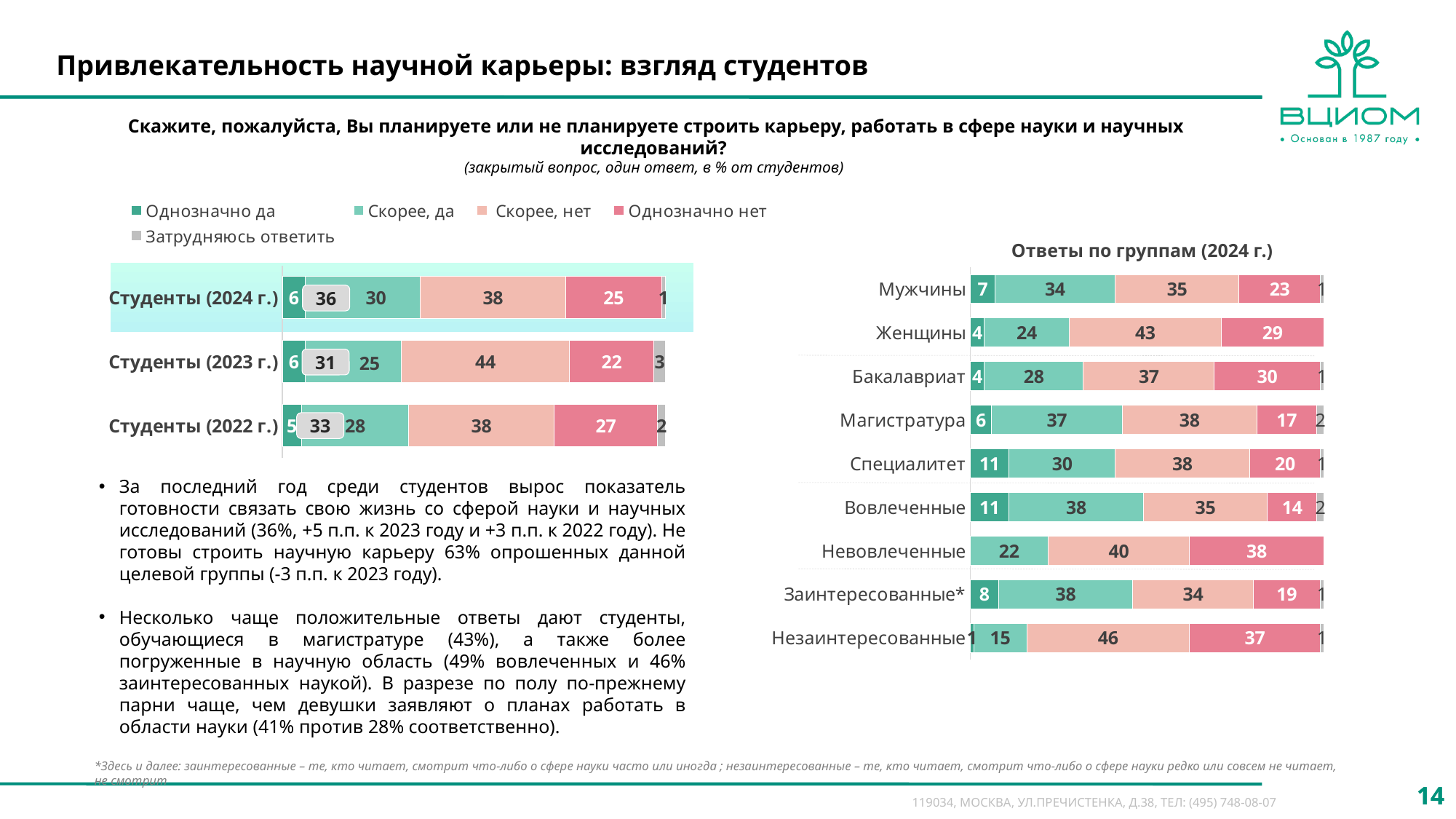
In the chart "Ответы по группам (2024 г.)", what is the value of "Скорее, нет" for Незаинтересованные? 46 How many groups are shown in the chart "Ответы по группам (2024 г.)"? 9 In the left chart, what is the value of "Однозначно нет" for Студенты (2022 г.)? 27 In the left chart, what is the value of "Затрудняюсь ответить" for Студенты (2023 г.)? 3 How many series does the legend of the left chart list? 5 In the left chart, which year has the highest value for "Скорее, да"? Студенты (2024 г.) What type of chart is "Ответы по группам (2024 г.)"? Stacked bar chart In the chart "Ответы по группам (2024 г.)", which group has the highest value for "Однозначно нет"? Невовлеченные In the chart "Ответы по группам (2024 г.)", which group has the lowest value for "Скорее, да"? Незаинтересованные In the left chart, what is the value of "Скорее, нет" for Студенты (2023 г.)? 44 In the left chart, what is the difference between the "Скорее, нет" values for Студенты (2023 г.) and Студенты (2024 г.)? 6 In the chart "Ответы по группам (2024 г.)", is the "Скорее, да" value larger for Мужчины or for Женщины? Мужчины